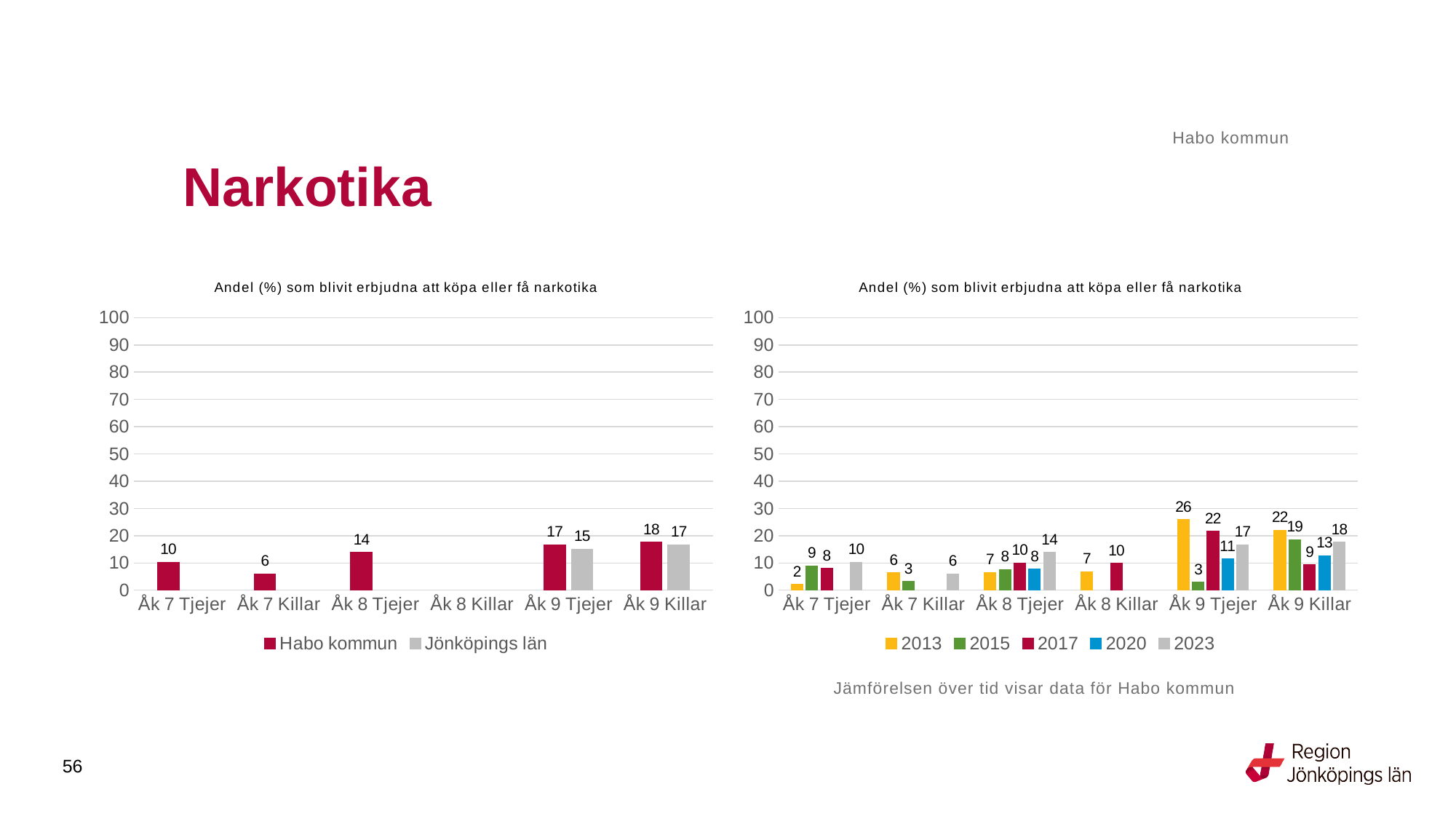
In the right chart, which is larger for Åk 9 Tjejer: 2017 or 2023? 2017 In the right chart, what is the difference between the 2013 and 2015 values for Åk 9 Tjejer? 23 In the left chart, which category has the highest value for Habo kommun? Åk 9 Killar In the left chart, what is the value for Jönköpings län for Åk 9 Tjejer? 15 In the right chart, what is the value for 2023 for Åk 8 Tjejer? 14 What kind of chart is the left chart? Bar chart In the right chart, what is the value for 2013 for Åk 9 Tjejer? 26 In the left chart, what is the difference between Habo kommun and Jönköpings län for Åk 9 Killar? 1 In the left chart, how many series does the legend list? 2 In the right chart, which year has the lowest value for Åk 9 Killar? 2017 In the right chart, how many series does the legend list? 5 In the left chart, what is the value for Habo kommun for Åk 8 Tjejer? 14